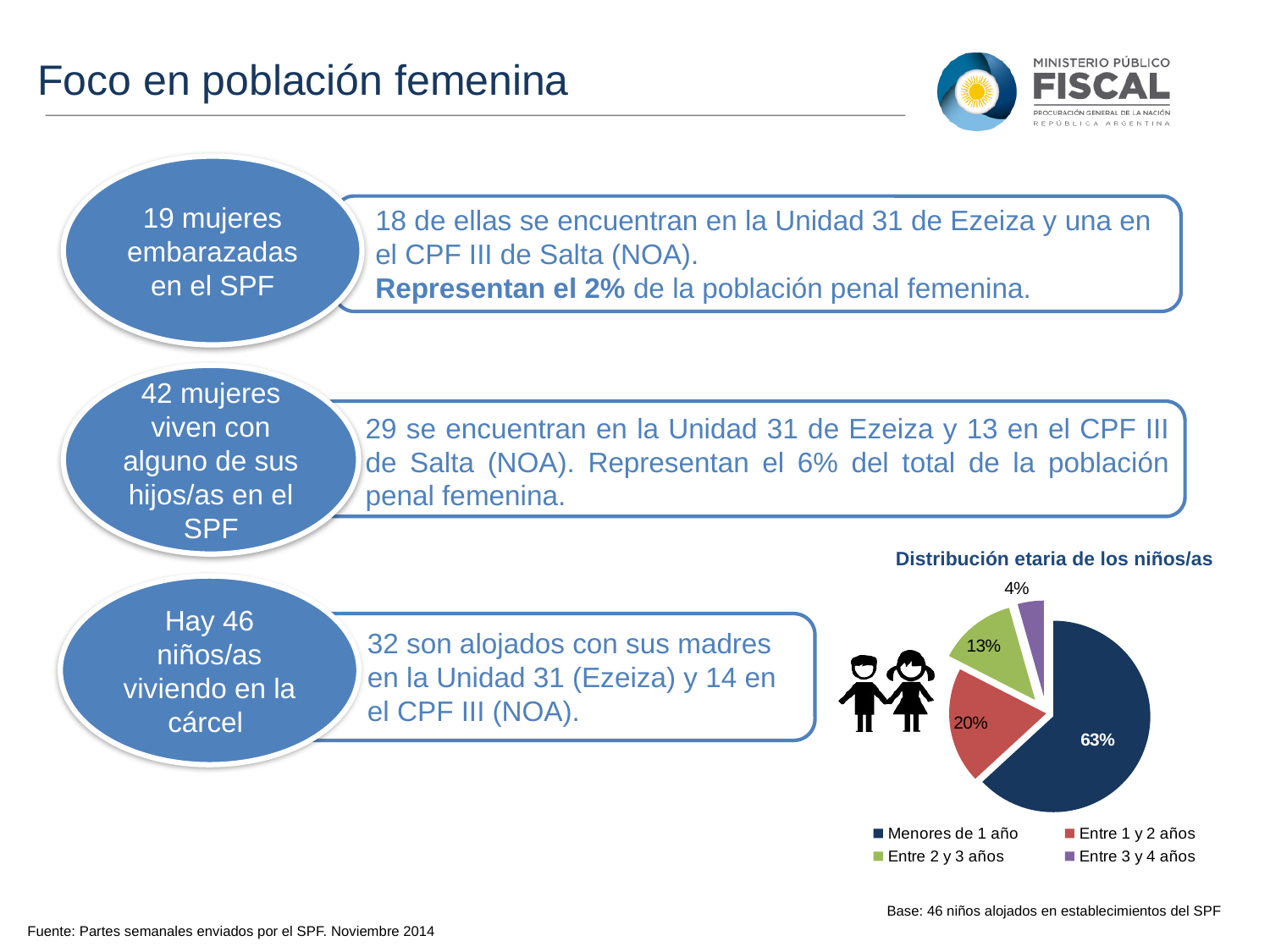
Which age group has the smallest slice in the pie chart? Entre 3 y 4 años Which is larger in the pie chart: 'Entre 2 y 3 años' or 'Entre 3 y 4 años'? Entre 2 y 3 años What share of the pie chart does 'Entre 3 y 4 años' represent? 4% What type of chart is shown under the title 'Distribución etaria de los niños/as'? pie chart What share of the pie chart does 'Entre 2 y 3 años' represent? 13% What share of the pie chart does 'Entre 1 y 2 años' represent? 20% What is the title of the pie chart? Distribución etaria de los niños/as What is the difference in percentage points between 'Menores de 1 año' and 'Entre 1 y 2 años' in the pie chart? 43 What share of the pie chart does 'Menores de 1 año' represent? 63% How many categories does the pie chart legend list? 4 What colour is the 'Entre 2 y 3 años' slice in the pie chart? green Which age group has the largest slice in the pie chart? Menores de 1 año